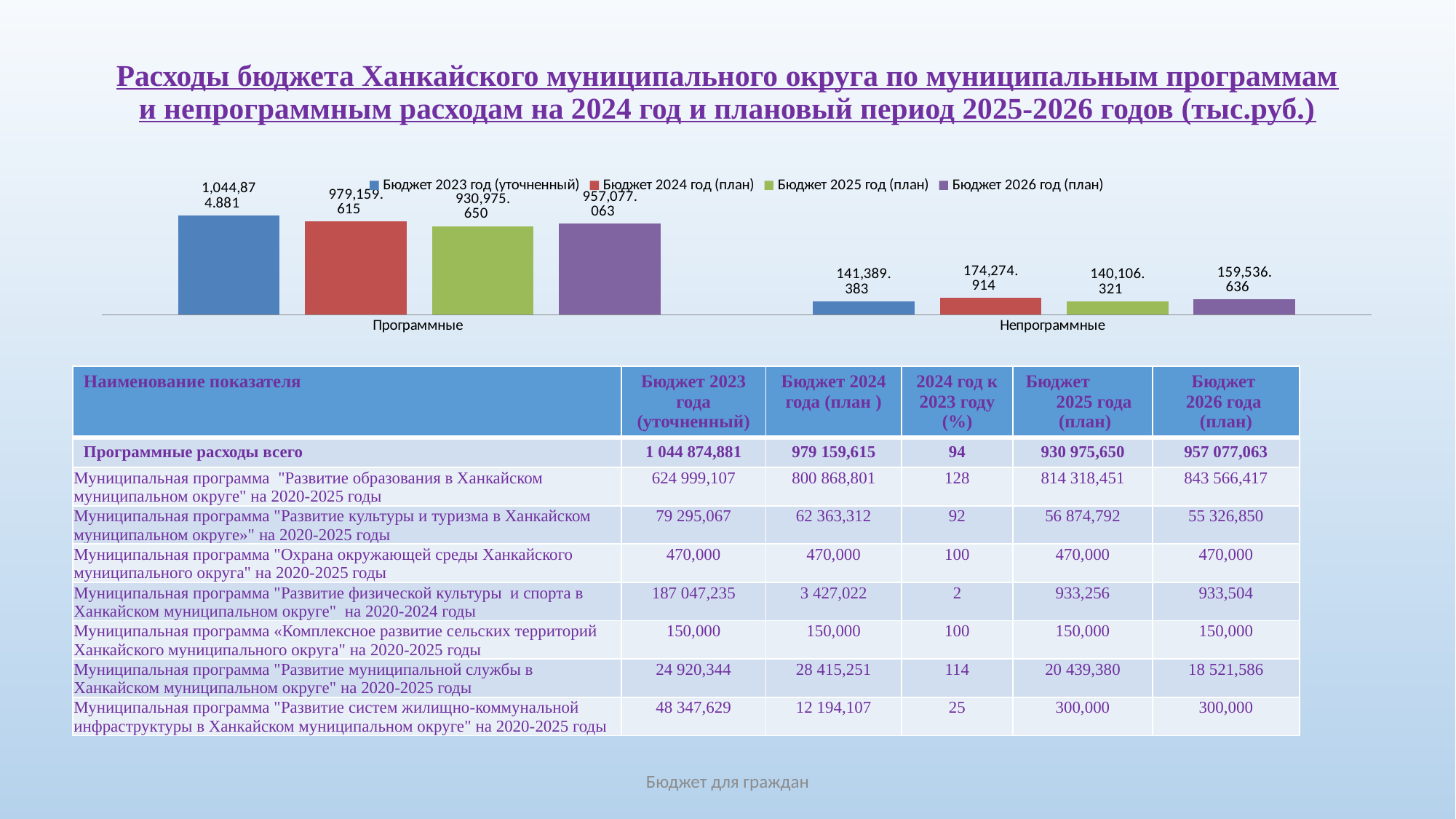
What is the value for Непрограммные in the series Бюджет 2025 год (план)? 140,106.321 Which series has the highest value for Непрограммные? Бюджет 2024 год (план) What is the value for Программные in the series Бюджет 2024 год (план)? 979,159.615 Which colour represents the series Бюджет 2026 год (план) in the chart? purple How many categories are shown on the x axis of the chart? 2 Which is larger for Программные: Бюджет 2025 год (план) or Бюджет 2026 год (план)? Бюджет 2026 год (план) What is the value for Программные in the series Бюджет 2023 год (уточненный)? 1,044,874.881 What is the difference between the Бюджет 2024 год (план) and Бюджет 2025 год (план) values for Непрограммные? 34,168.593 Which series has the lowest value for Программные? Бюджет 2025 год (план) What type of chart is shown on the slide? bar chart How many series does the chart legend list? 4 What is the value for Непрограммные in the series Бюджет 2026 год (план)? 159,536.636